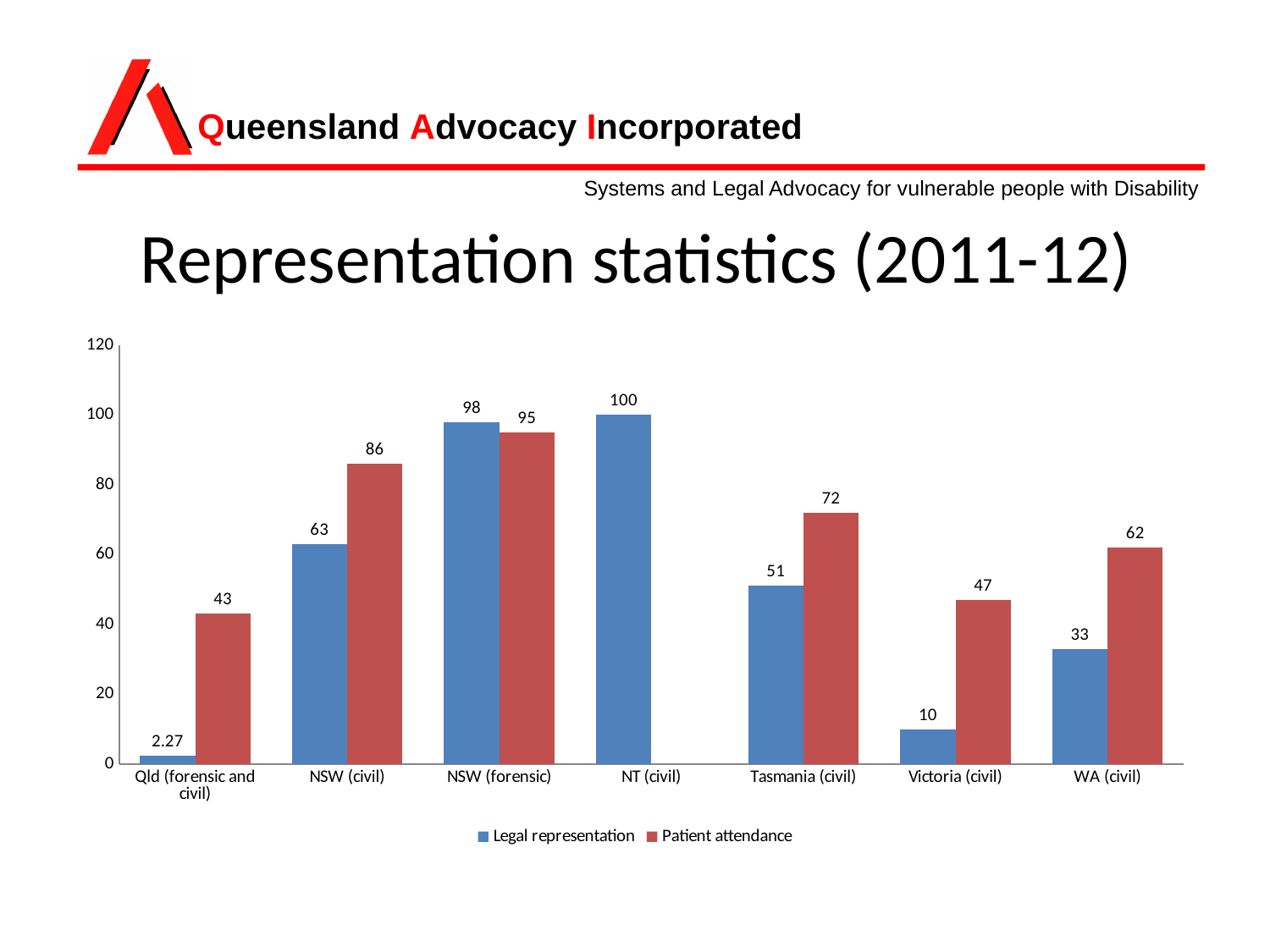
Which category has the lowest Patient attendance value? Qld (forensic and civil) What is the Legal representation value for Qld (forensic and civil)? 2.27 How many series does the legend list? 2 What is the title of the slide? Representation statistics (2011-12) What kind of chart is shown on the slide? Bar chart How many categories are shown on the x axis? 7 Which category has the highest Legal representation value? NT (civil) What is the Legal representation value for NSW (forensic)? 98 Which is larger for NSW (civil): Legal representation or Patient attendance? Patient attendance Which colour represents Patient attendance in the legend? Red What is the difference between Patient attendance and Legal representation for Victoria (civil)? 37 What is the Patient attendance value for Tasmania (civil)? 72